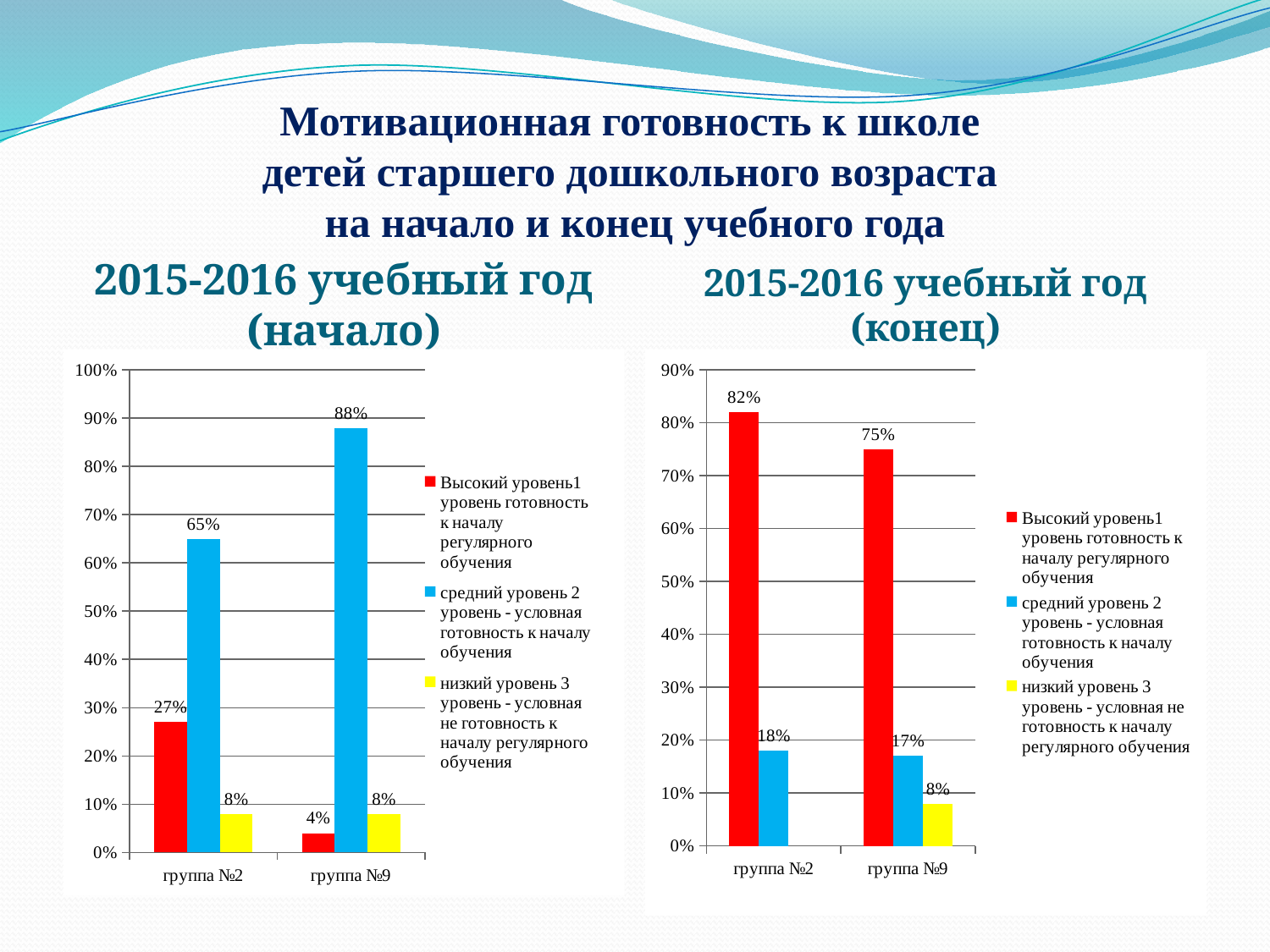
How many series does the legend of the right chart (2015-2016 учебный год (конец)) list? 3 In the right chart (2015-2016 учебный год (конец)), what is the difference between the Высокий уровень values for группа №2 and группа №9? 7% In the left chart (2015-2016 учебный год (начало)), what is the value for группа №2 in the series Высокий уровень? 27% In the right chart (2015-2016 учебный год (конец)), which bar is the highest? группа №2, Высокий уровень (82%) In the right chart (2015-2016 учебный год (конец)), what is the value for группа №9 in the series средний уровень? 17% In the right chart (2015-2016 учебный год (конец)), what is the value for группа №2 in the series Высокий уровень? 82% How many groups are shown on the x axis of the left chart (2015-2016 учебный год (начало))? 2 What type of chart is the left chart (2015-2016 учебный год (начало))? Bar chart In the left chart (2015-2016 учебный год (начало)), which bar is the lowest? группа №9, Высокий уровень (4%) In the left chart (2015-2016 учебный год (начало)), what is the difference between the средний уровень values for группа №9 and группа №2? 23% In the left chart (2015-2016 учебный год (начало)), what is the value for группа №9 in the series средний уровень? 88% In the left chart (2015-2016 учебный год (начало)), which group has the higher value in the series средний уровень? группа №9